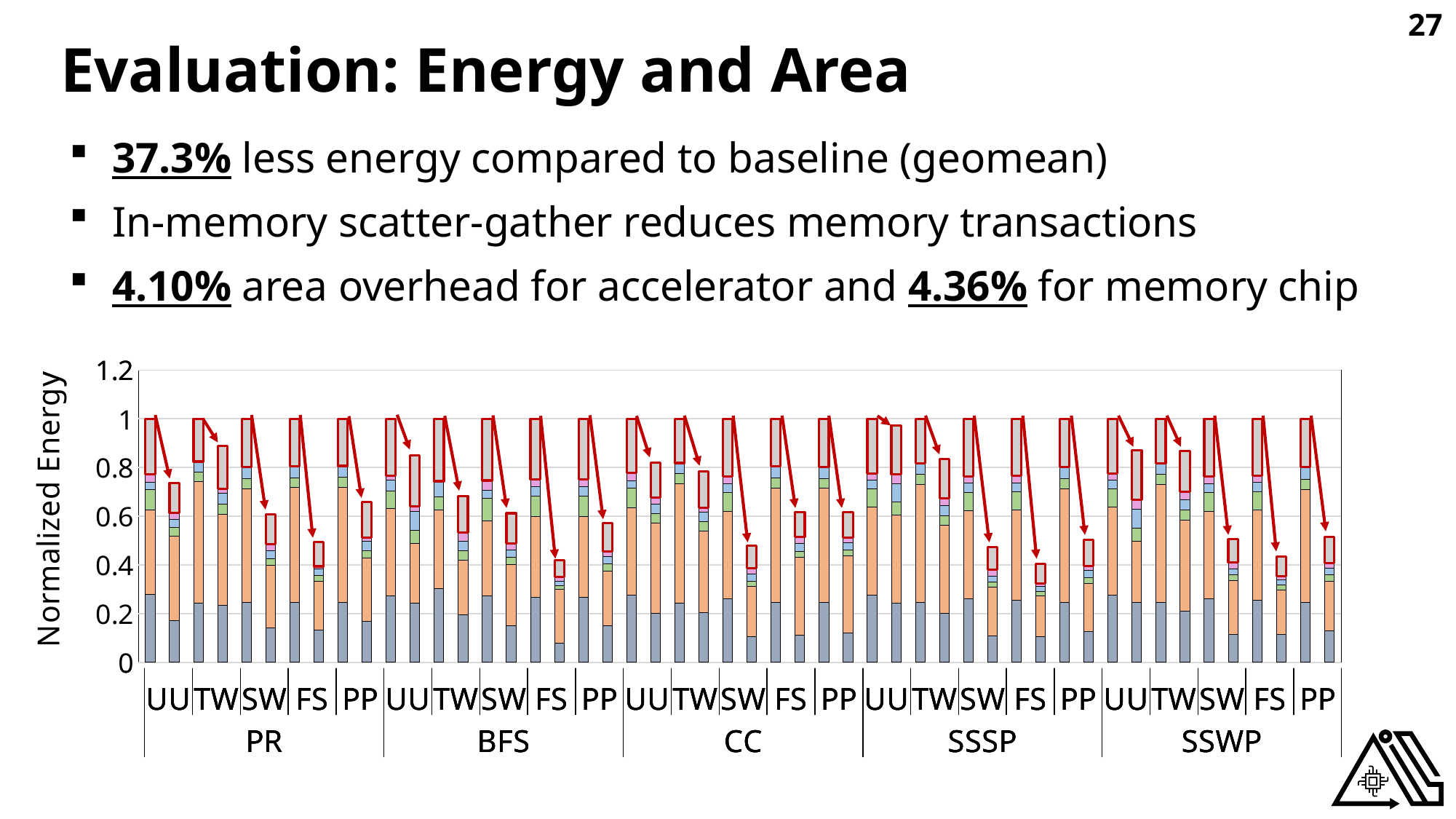
Within the SSSP group, which dataset has the highest second bar? UU Is the normalized energy of the second bar for FS under PR greater or less than 0.6? less How many algorithm groups (PR, BFS, etc.) are shown along the x axis of the chart? 5 What kind of chart is shown on the slide? stacked bar chart Within the BFS group, which dataset has the lowest second bar? FS Is the normalized energy of the second bar for FS under SSSP greater or less than 0.6? less Within the PR group, which has the larger second bar: UU or FS? UU What is the normalized energy of the first (baseline) bar for UU under PR? 1 What is the highest tick value shown on the vertical axis of the chart? 1.2 How many dataset labels (UU, TW, SW, FS, PP) appear within each algorithm group on the x axis? 5 Is the normalized energy of the second bar for UU under CC greater or less than 0.6? greater What is the label of the vertical axis of the chart? Normalized Energy